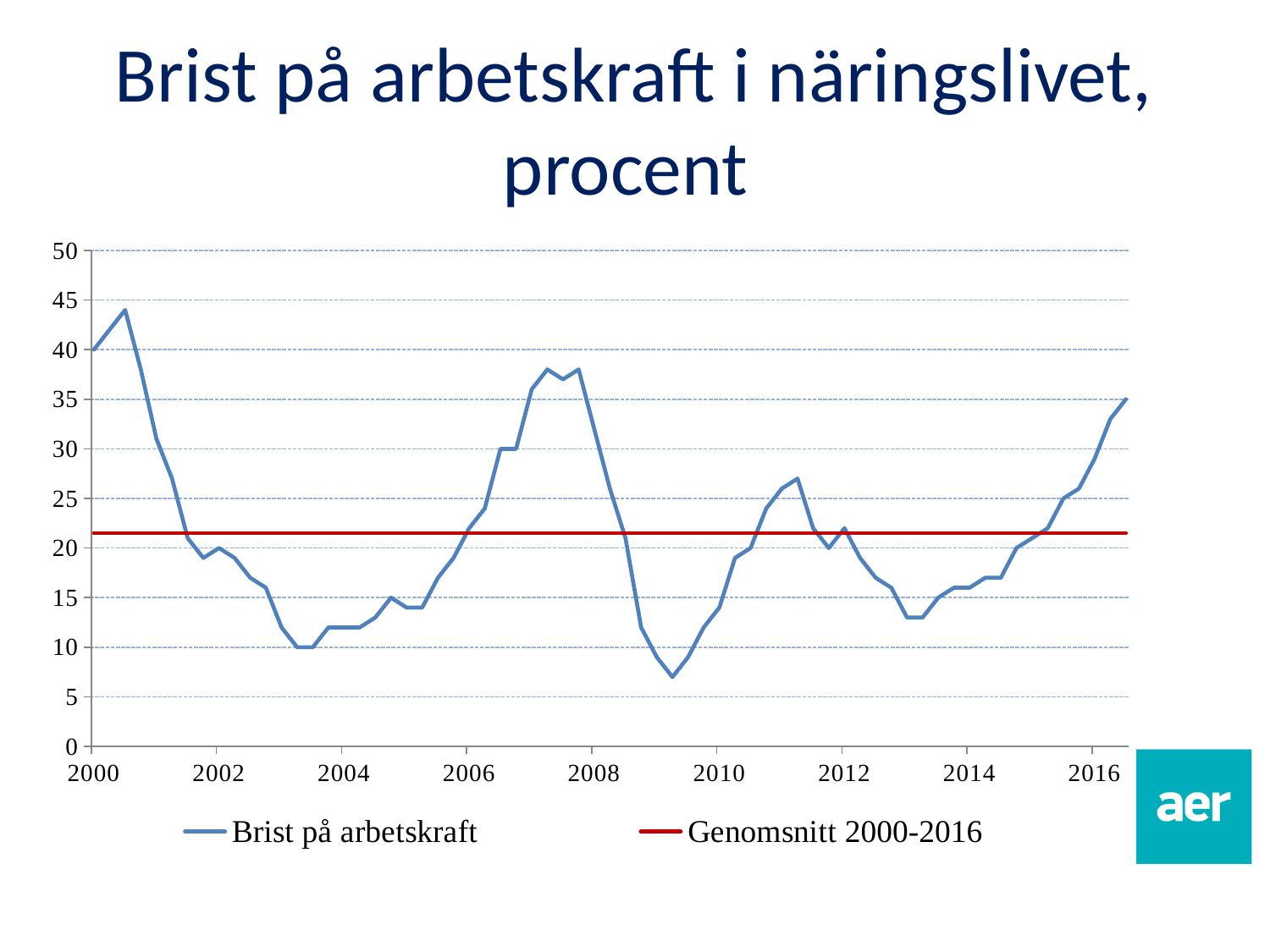
Which is larger, the value for Brist på arbetskraft at 2004 or at 2008? 2008 How many series does the legend list? 2 What kind of chart is shown on the slide? line chart What is the title of the chart? Brist på arbetskraft i näringslivet, procent What colour is the line for Genomsnitt 2000-2016? red In which year does Brist på arbetskraft reach its lowest point? 2009 Is the value for Brist på arbetskraft at 2016 greater or less than 25? greater Is the value for Brist på arbetskraft at 2004 greater or less than 15? less Is the value for Brist på arbetskraft at 2010 greater or less than 20? less Does Brist på arbetskraft rise or fall between 2014 and 2016? rise